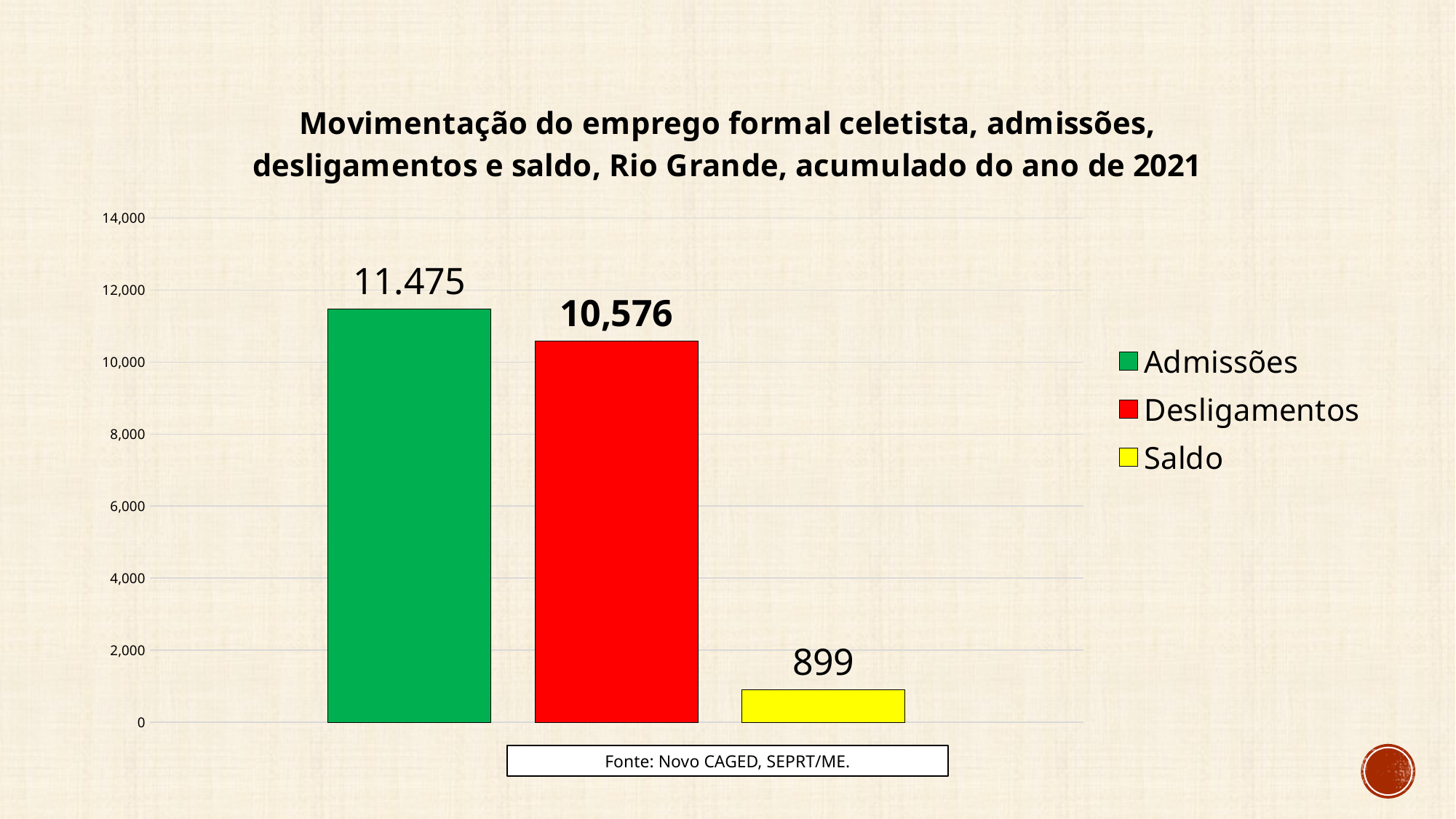
What is the difference between Admissões and Desligamentos? 899 Is the value for Saldo greater or less than 2,000? less What is the value shown for Saldo? 899 What is the value shown for Admissões? 11.475 How many series does the legend list? 3 Which bar has the lowest value? Saldo What kind of chart is shown on the slide? Bar chart How many bars are plotted in the chart? 3 Is the value for Desligamentos greater or less than 10,000? greater What is the value shown for Desligamentos? 10,576 Which is larger, Admissões or Desligamentos? Admissões Which bar has the highest value? Admissões